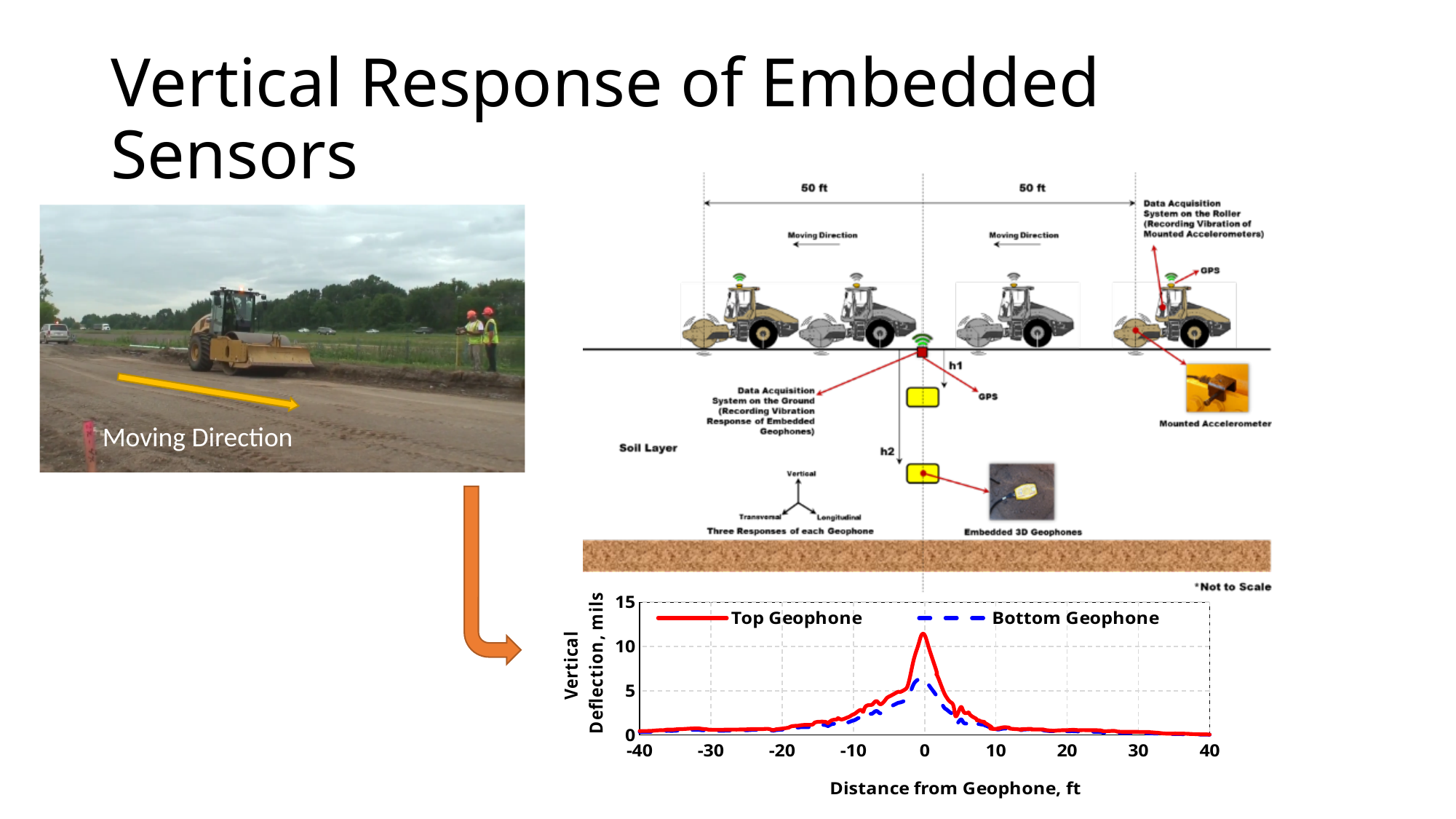
What kind of chart is shown at the bottom right of the slide? line chart Is the peak value of the Bottom Geophone series greater or less than 10 mils? less Which series reaches the higher peak deflection, Top Geophone or Bottom Geophone? Top Geophone How many series does the legend of the deflection chart list? 2 What is the x-axis title of the deflection chart? Distance from Geophone, ft Do the deflection values rise or fall as the distance goes from 0 ft to 40 ft? fall What are the two series named in the legend of the deflection chart? Top Geophone and Bottom Geophone At what distance from the geophone does the Top Geophone deflection reach its maximum? 0 ft Is the Top Geophone value at a distance of -40 ft greater or less than 5 mils? less Do the deflection values rise or fall as the distance goes from -40 ft to 0 ft? rise Is the peak value of the Top Geophone series greater or less than 10 mils? greater